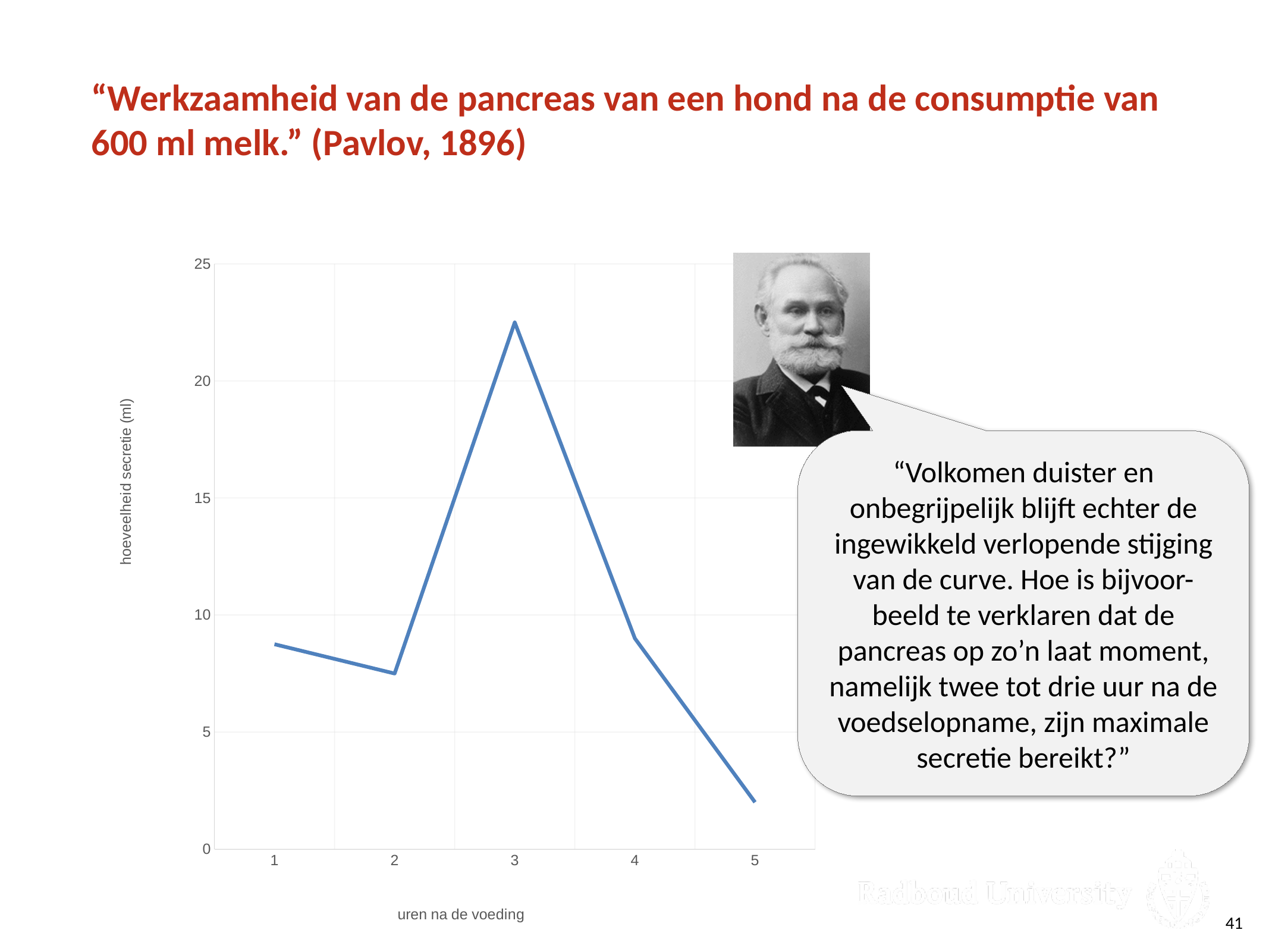
At how many hours after feeding is the secretion lowest? 5 What is the label of the y axis? hoeveelheid secretie (ml) Is the secretion value at hour 4 greater or less than 5? greater At how many hours after feeding (uren na de voeding) is the secretion highest? 3 How many data points are plotted on the line? 5 Is the secretion value at hour 1 greater or less than 10? less Which has the larger secretion value, hour 2 or hour 5? hour 2 Is the secretion value at hour 3 greater or less than 20? greater What kind of chart is shown on the slide? line chart Which has the larger secretion value, hour 3 or hour 4? hour 3 Does the secretion rise or fall from hour 3 to hour 5? fall